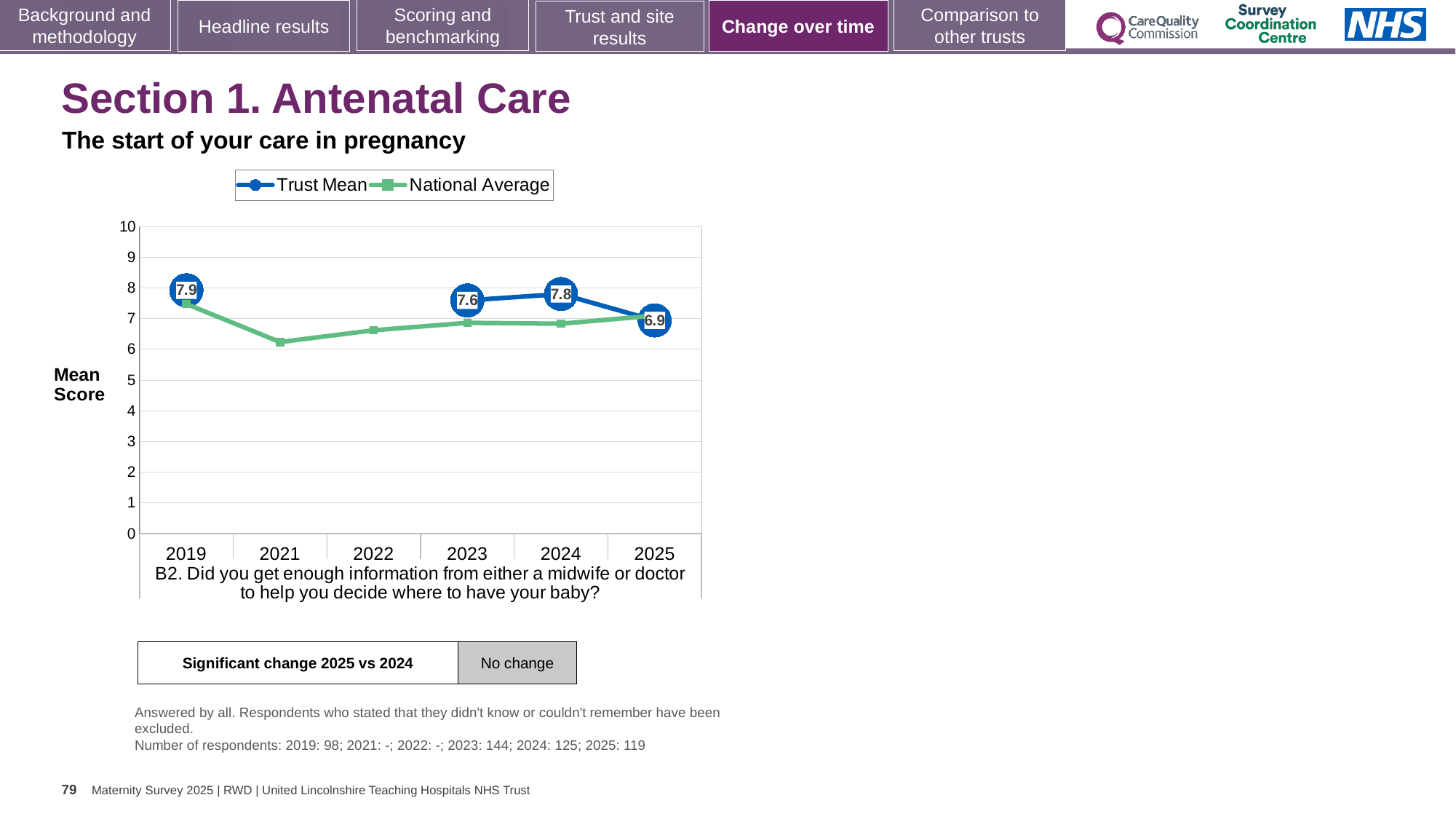
Is the National Average value for 2021 greater or less than 7? less What is the Trust Mean score for 2019? 7.9 Which year has the larger Trust Mean score, 2023 or 2024? 2024 In which year is the labelled Trust Mean score lowest? 2025 What is the Trust Mean score for 2025? 6.9 Does the Trust Mean score rise or fall from 2024 to 2025? fall In which year is the labelled Trust Mean score highest? 2019 What is the difference between the Trust Mean scores for 2024 and 2025? 0.9 How many years are shown on the x axis? 6 What kind of chart is shown on the slide? line chart How many series does the legend list? 2 What is the Trust Mean score for 2024? 7.8